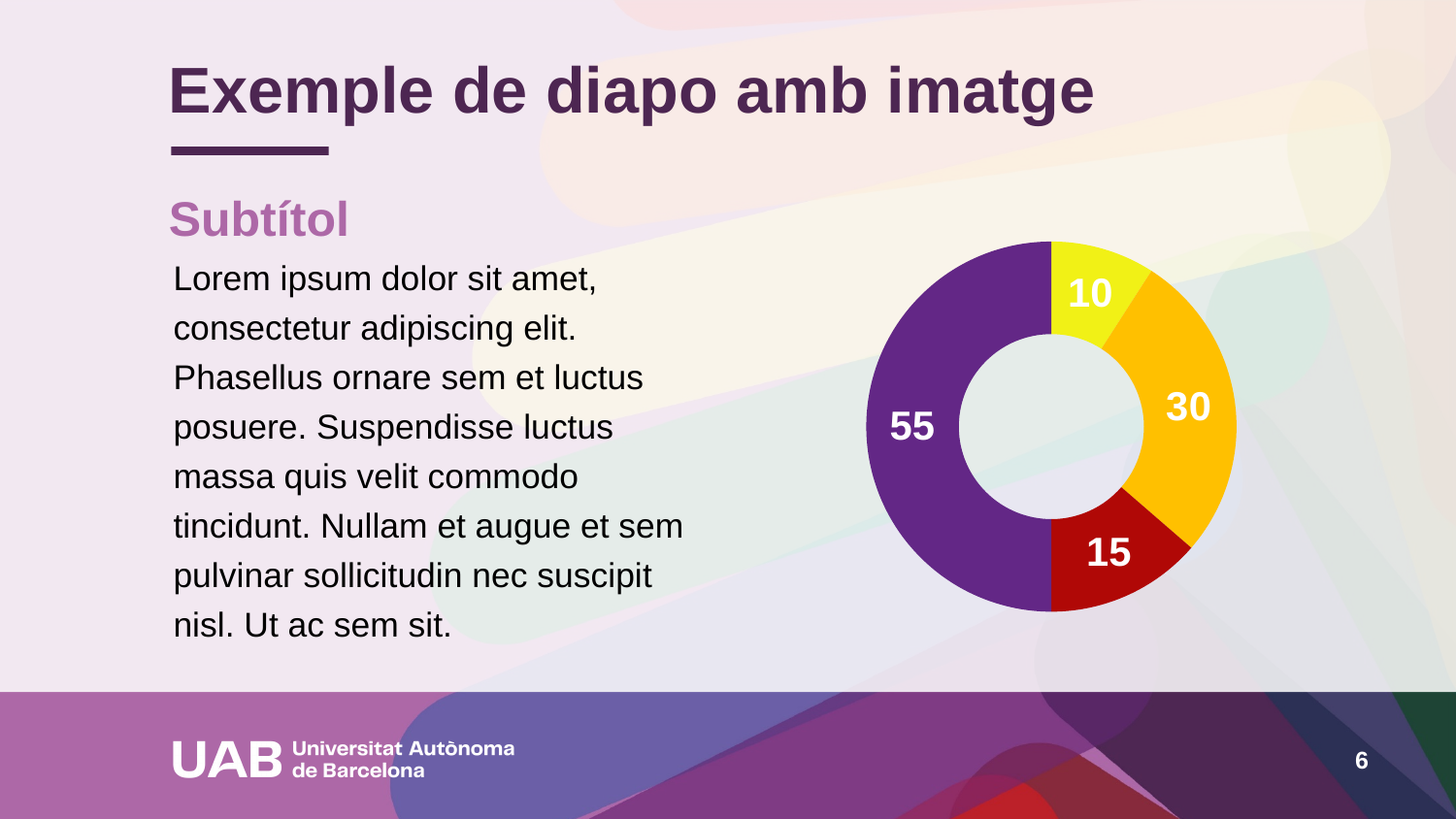
How many slices does the doughnut chart have? 4 What is the value shown on the orange slice of the doughnut chart? 30 What is the total of all the values shown in the doughnut chart? 110 Which is larger in the doughnut chart, the orange slice or the red slice? The orange slice What is the value shown on the red slice of the doughnut chart? 15 What is the value shown on the yellow slice of the doughnut chart? 10 What share of the doughnut chart's total does the purple slice (55) represent? 50% Which slice of the doughnut chart has the largest value? The purple slice (55) What is the value shown on the purple slice of the doughnut chart? 55 What is the difference between the purple slice and the orange slice in the doughnut chart? 25 Which slice of the doughnut chart has the smallest value? The yellow slice (10) What kind of chart is shown on the slide? Doughnut chart